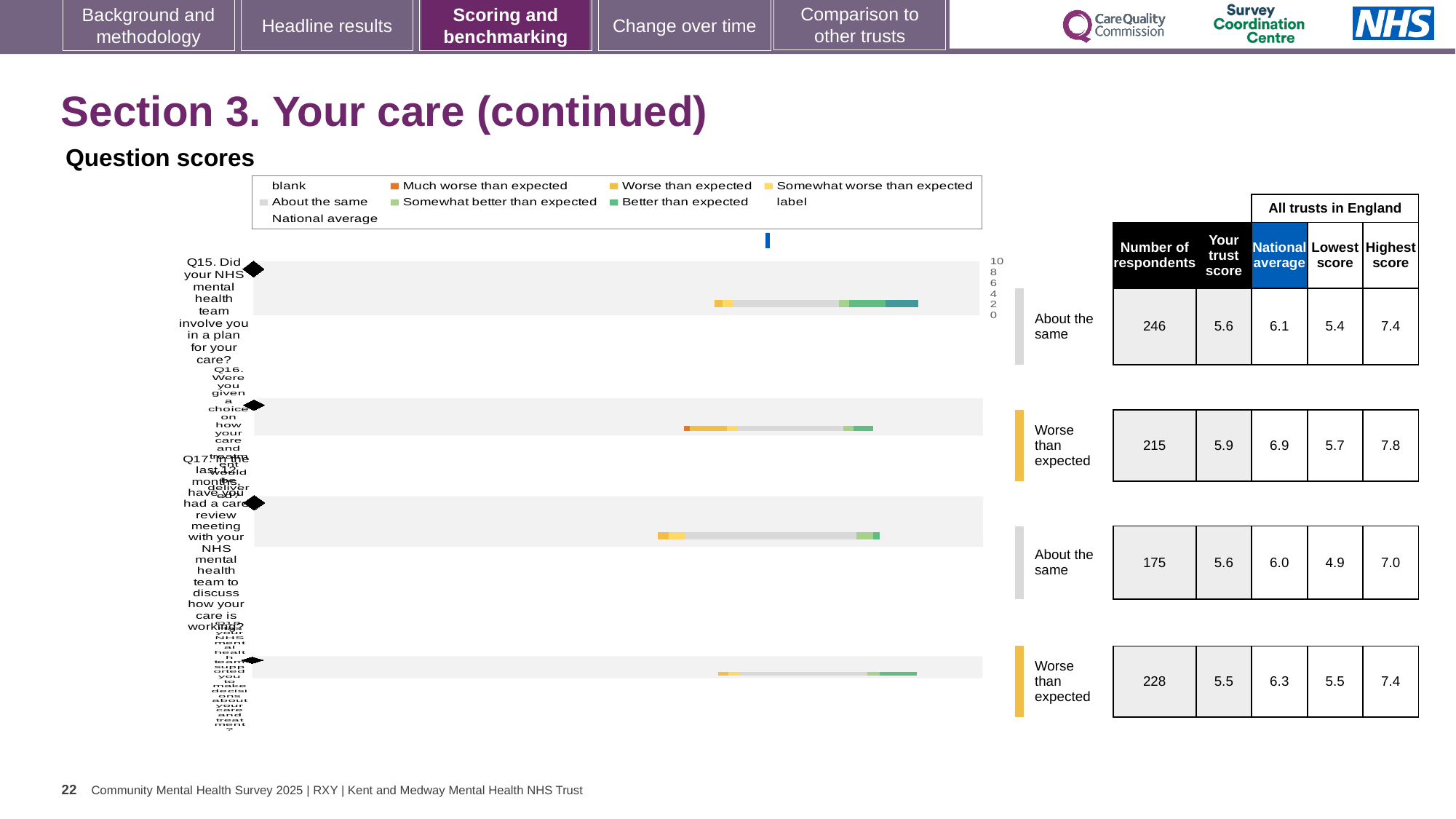
How many questions (rows) are plotted in the question scores chart? 4 How many respondents are listed for Q15 (Did your NHS mental health team involve you in a plan for your care?)? 246 What benchmark category is shown for Q15 (involve you in a plan for your care)? About the same Which question row has the lowest number of respondents? Q17 For the second question row (Q16), what is the difference between the national average (6.9) and the trust score (5.9)? 1.0 Which is larger for the fourth question row (Q18): the trust score or the national average? National average What is the trust's score for Q15 (involve you in a plan for your care)? 5.6 Which question row has the highest number of respondents? Q15 What is the national average for Q17 (care review meeting in the last 12 months)? 6.0 What kind of chart is used to show the question scores on this slide? bar chart What benchmark category is shown for the second question row (Q16)? Worse than expected What is the lowest score among all trusts in England for Q17 (care review meeting)? 4.9